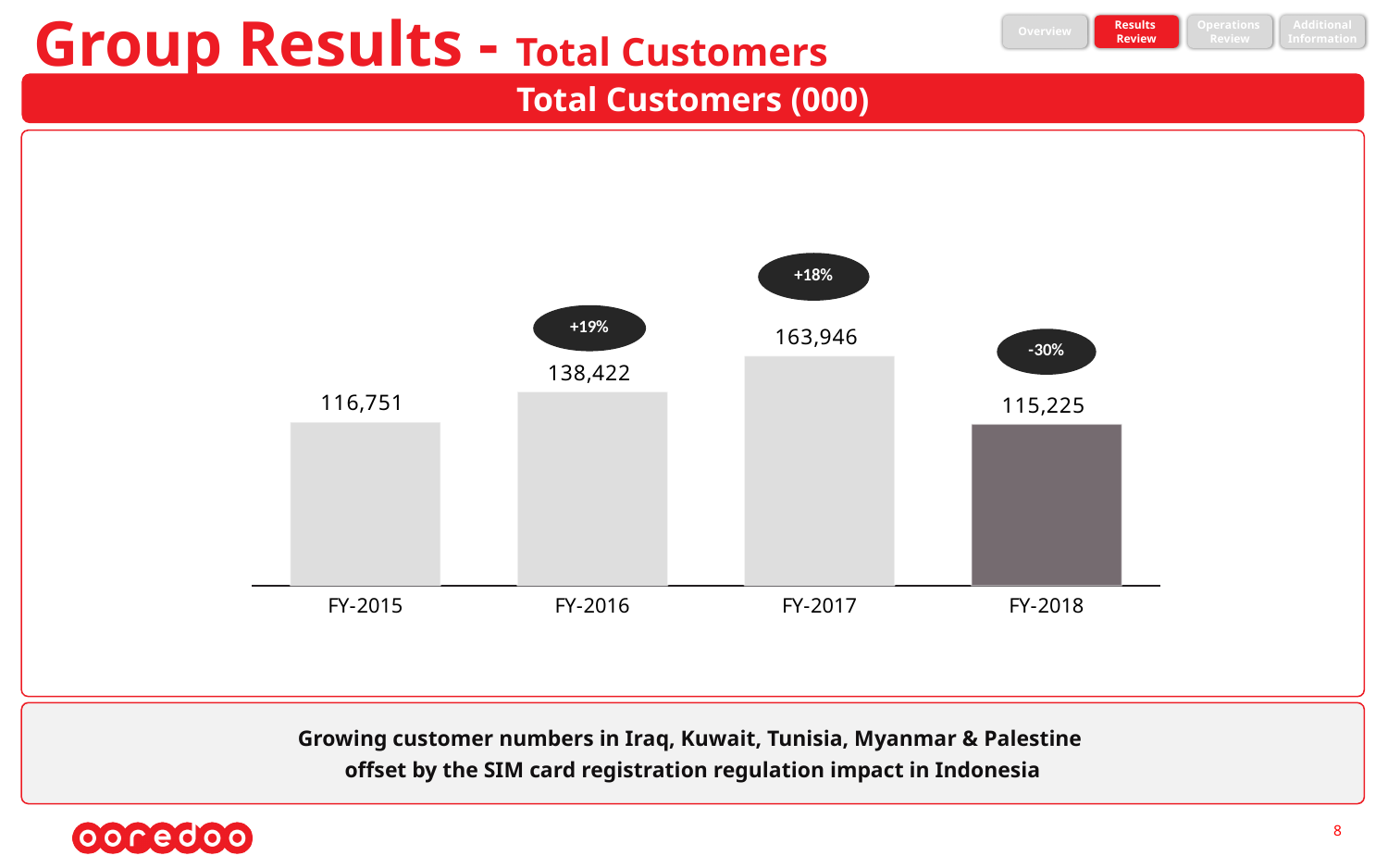
What is the difference in total customers between FY-2017 and FY-2016? 25,524 What is the total customers value for FY-2015? 116,751 How many years are shown on the chart? 4 What is the total customers value for FY-2017? 163,946 What percentage change is shown above the FY-2018 bar? -30% What is the title of the chart? Total Customers (000) What is the difference in total customers between FY-2017 and FY-2018? 48,721 What kind of chart is shown on the slide? Bar chart Which year has the highest total customers? FY-2017 Which is larger, the total customers for FY-2016 or FY-2018? FY-2016 Which year has the lowest total customers? FY-2018 What is the total customers value for FY-2018? 115,225